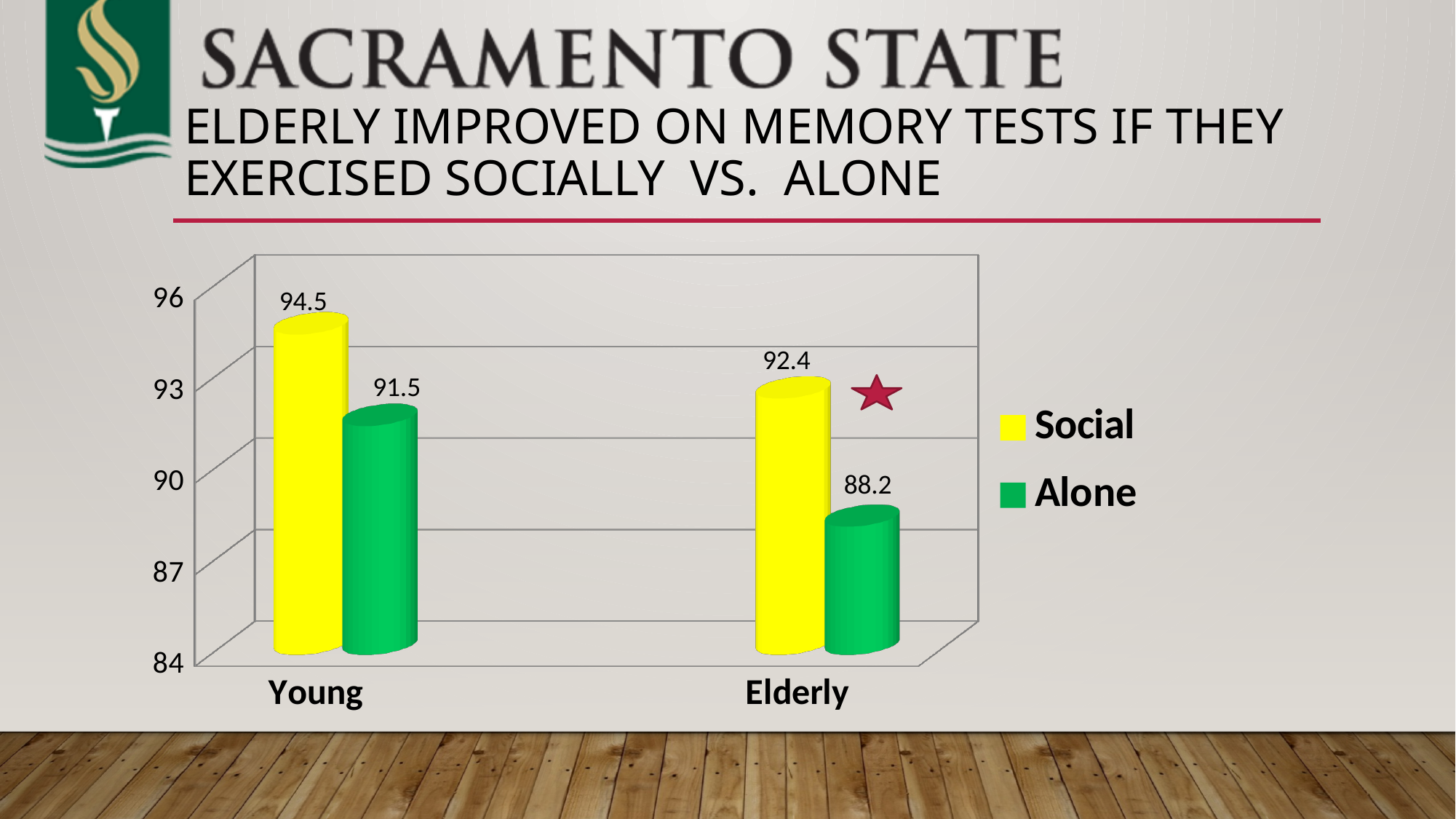
Which is larger for the Elderly group, the Social value or the Alone value? Social What is the difference between the Social and Alone values for the Elderly group? 4.2 How many groups are shown on the x axis? 2 What is the Social value for the Elderly group? 92.4 Which group has the highest Social value? Young What is the Alone value for the Young group? 91.5 What is the difference between the Social and Alone values for the Young group? 3 What kind of chart is shown on the slide? Bar chart What is the Social value for the Young group? 94.5 How many series does the legend list? 2 What is the Alone value for the Elderly group? 88.2 Which group has the lowest Alone value? Elderly